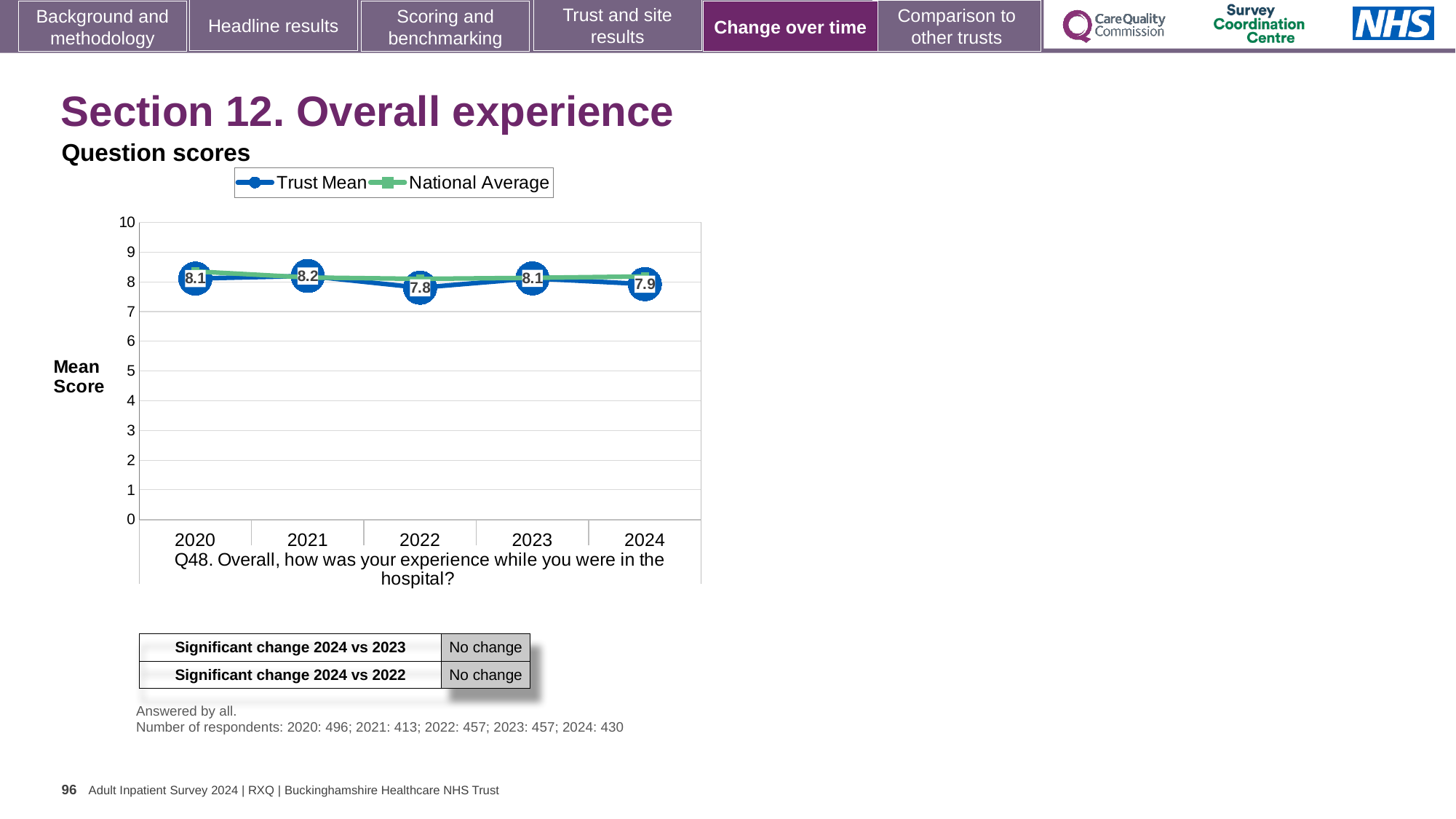
What is the Trust Mean for 2020? 8.1 Which is larger, the Trust Mean for 2023 or for 2024? 2023 Does the Trust Mean rise or fall from 2021 to 2022? Fall How many years are plotted on the x axis? 5 What is the Trust Mean for 2022? 7.8 What is the Trust Mean for 2024? 7.9 What is the difference between the Trust Mean in 2021 and in 2022? 0.4 In which year is the Trust Mean lowest? 2022 In which year is the Trust Mean highest? 2021 What kind of chart is shown? Line chart Is the National Average value for 2024 greater or less than 5? greater How many series does the legend list? 2